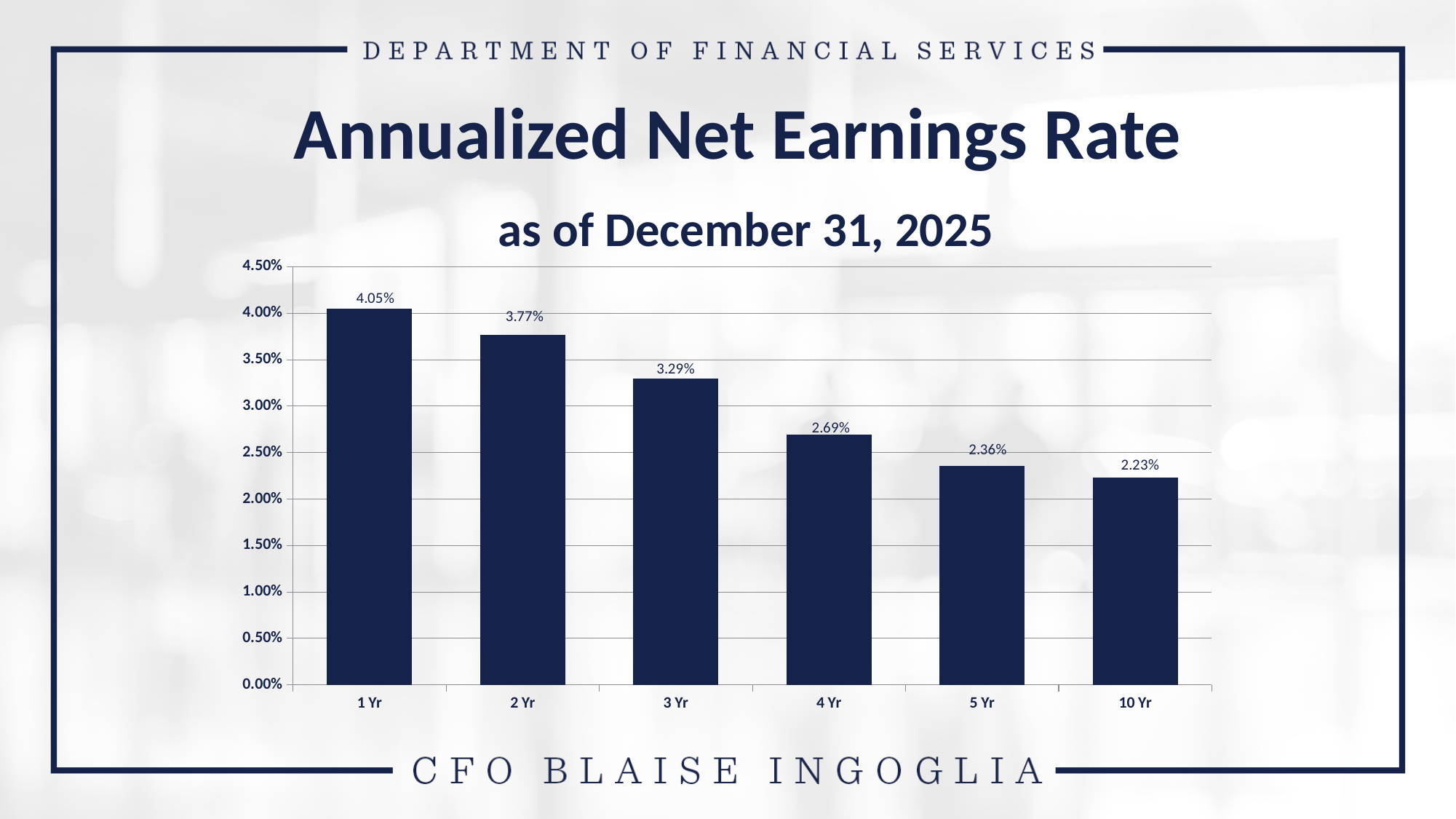
Is the value for 5 Yr greater or less than 2.50%? less What is the difference between the 1 Yr and 2 Yr annualized net earnings rates? 0.28% Which is larger, the 2 Yr rate or the 4 Yr rate? 2 Yr How many periods are shown on the x axis? 6 What is the annualized net earnings rate for 10 Yr? 2.23% Which period has the highest annualized net earnings rate? 1 Yr Do the values rise or fall as the period lengthens from 1 Yr to 10 Yr? Fall Which period has the lowest annualized net earnings rate? 10 Yr What is the annualized net earnings rate for 3 Yr? 3.29% What is the annualized net earnings rate for 1 Yr? 4.05% What is the difference between the 4 Yr and 5 Yr annualized net earnings rates? 0.33% What kind of chart is shown on the slide? Bar chart